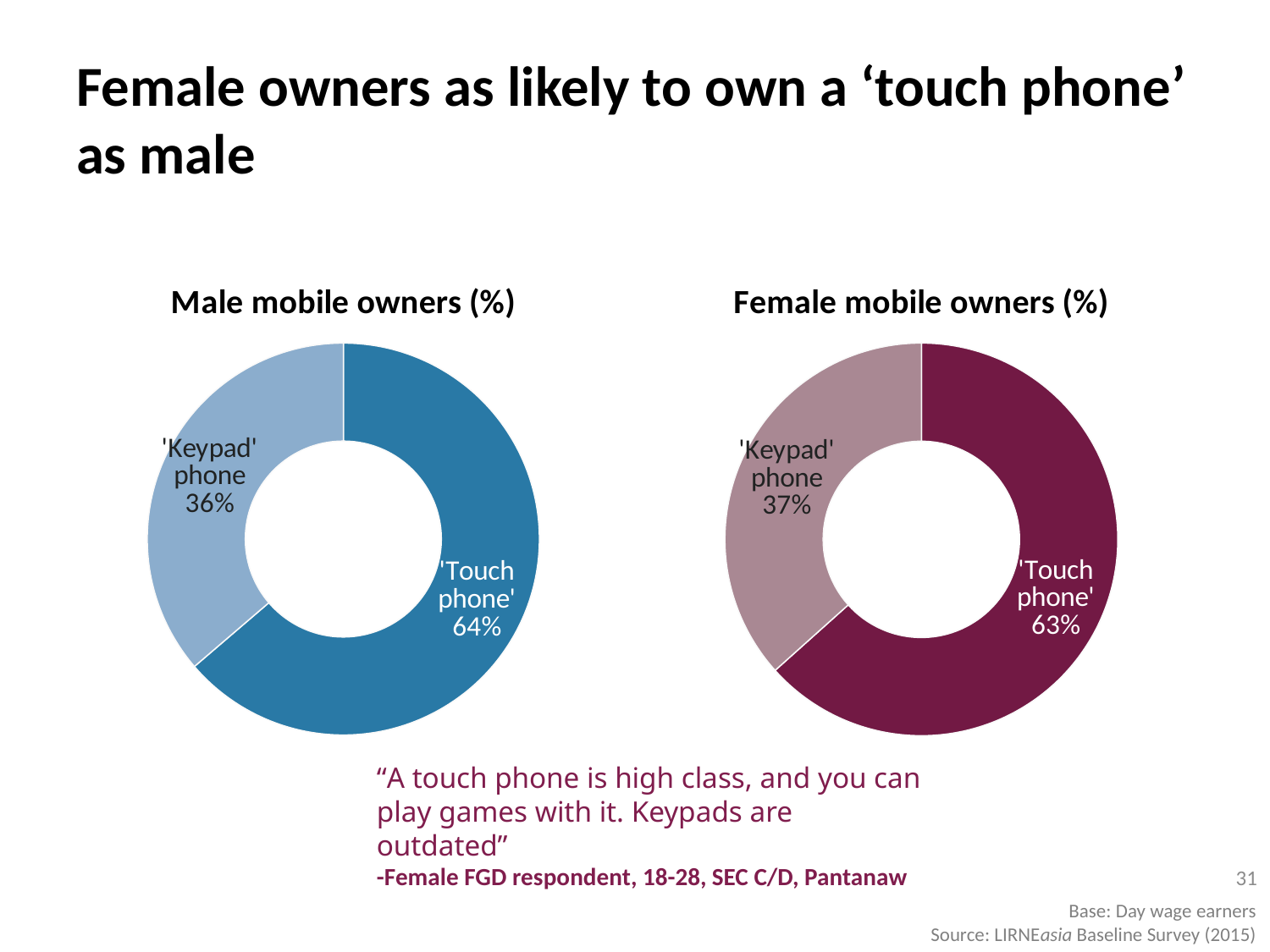
In the 'Male mobile owners (%)' chart, what percentage of male mobile owners have a 'Touch phone'? 64% In the 'Male mobile owners (%)' chart, which category has the largest share? 'Touch phone' In the 'Male mobile owners (%)' chart, what percentage of male mobile owners have a 'Keypad' phone? 36% In the 'Female mobile owners (%)' chart, what is the difference in percentage points between 'Touch phone' and 'Keypad' phone? 26 In the 'Female mobile owners (%)' chart, which category has the smallest share? 'Keypad' phone In the 'Female mobile owners (%)' chart, which is larger: the 'Touch phone' share or the 'Keypad' phone share? 'Touch phone' How many categories does the 'Male mobile owners (%)' chart show? 2 What kind of chart is the 'Female mobile owners (%)' chart? Doughnut chart In the 'Female mobile owners (%)' chart, what percentage of female mobile owners have a 'Touch phone'? 63% In the 'Female mobile owners (%)' chart, what percentage of female mobile owners have a 'Keypad' phone? 37% In the 'Male mobile owners (%)' chart, what is the difference in percentage points between 'Touch phone' and 'Keypad' phone? 28 What is the title of the chart on the left side of the slide? Male mobile owners (%)